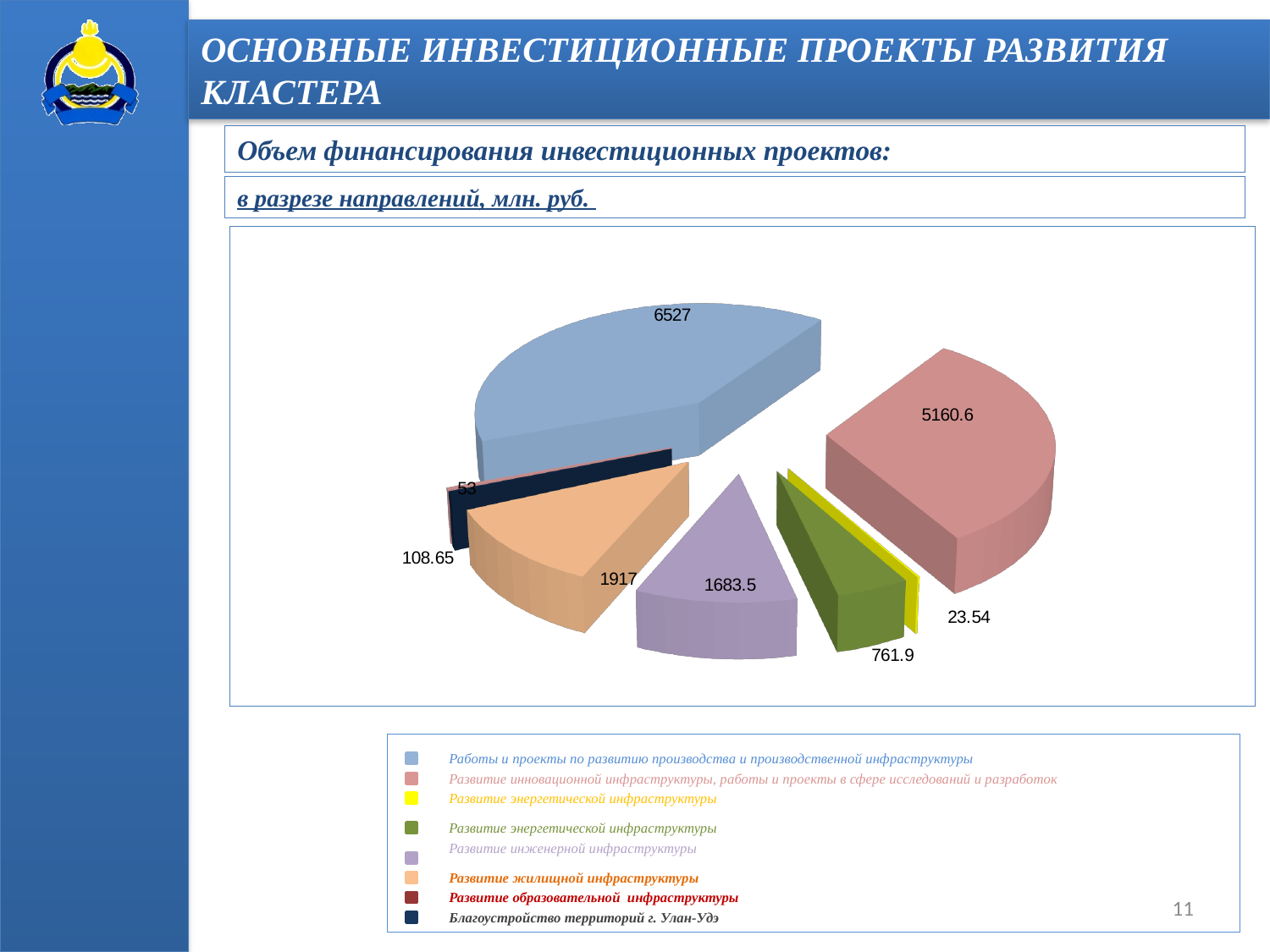
What is the value for 'Развитие жилищной инфраструктуры'? 1917 What is the value for 'Работы и проекты по развитию производства и производственной инфраструктуры'? 6527 What is the difference between the value for 'Работы и проекты по развитию производства и производственной инфраструктуры' and the value for 'Развитие инновационной инфраструктуры, работы и проекты в сфере исследований и разработок'? 1366.4 What is the smallest value labelled on the pie chart? 23.54 What is the value for 'Развитие инновационной инфраструктуры, работы и проекты в сфере исследований и разработок'? 5160.6 Which category has the largest slice of the pie? Работы и проекты по развитию производства и производственной инфраструктуры What is the value for 'Развитие инженерной инфраструктуры'? 1683.5 What is the difference between the values for 'Развитие жилищной инфраструктуры' and 'Развитие инженерной инфраструктуры'? 233.5 Which is larger: the value for 'Развитие жилищной инфраструктуры' or the value for 'Развитие инженерной инфраструктуры'? Развитие жилищной инфраструктуры What kind of chart is shown on the slide? pie chart How many entries does the legend list? 8 How many slices does the pie chart have? 8